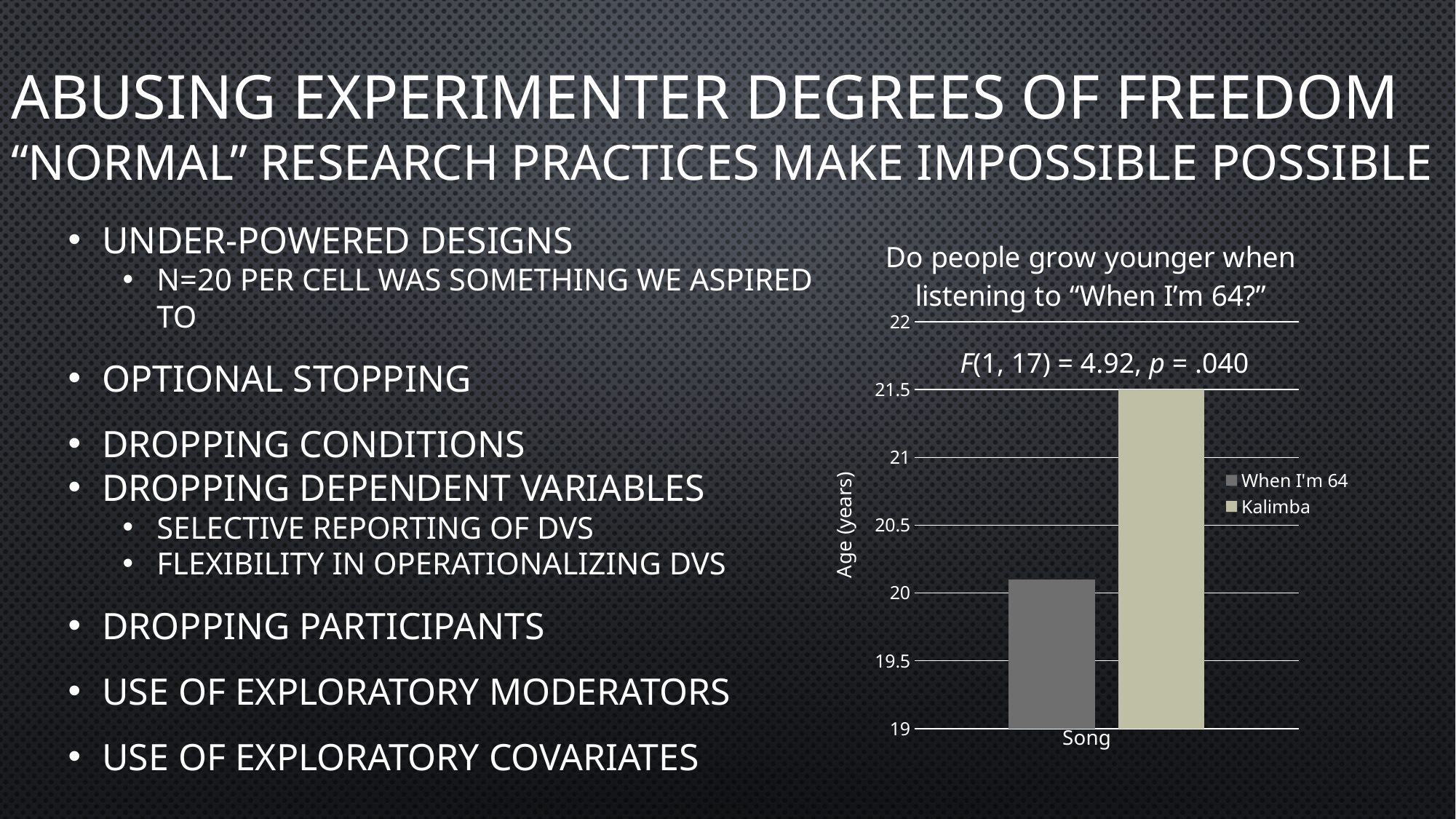
Is the value for Kalimba greater or less than 21? greater How many series does the chart's legend list? 2 What is the label of the chart's y axis? Age (years) What kind of chart is shown on the slide? bar chart How many categories are shown on the x axis of the chart? 1 Which series has the lower bar in the chart? When I'm 64 Is the value for When I'm 64 greater or less than 19.5? greater Which series has the higher bar in the chart? Kalimba What is the category label on the chart's x axis? Song Is the value for When I'm 64 greater or less than 20.5? less Is the bar for Kalimba taller or shorter than the bar for When I'm 64? taller